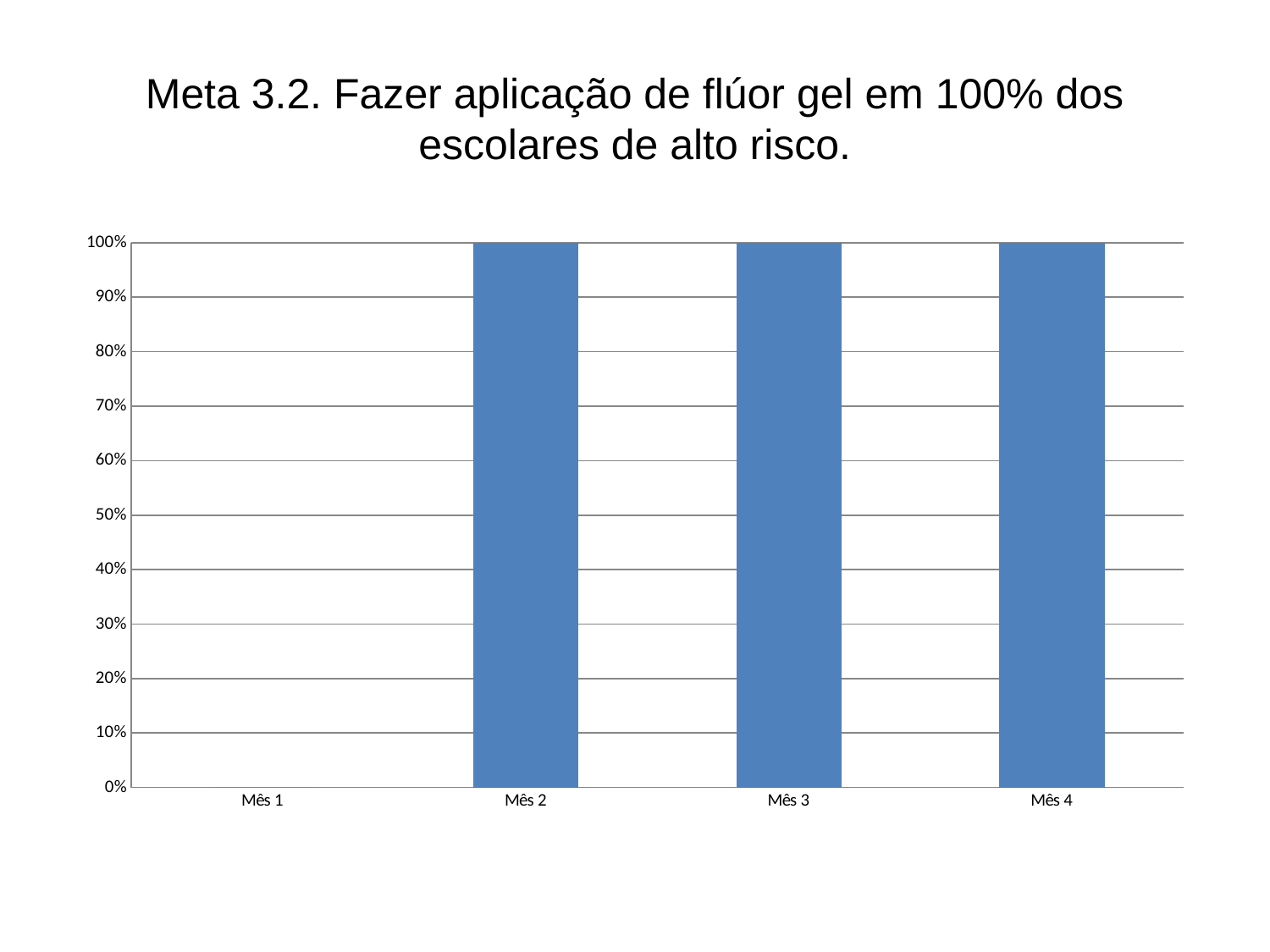
What is the highest tick value shown on the vertical axis? 100% What is the value for Mês 2? 100% What is the value for Mês 4? 100% Do the values rise or fall from Mês 1 to Mês 2? rise Which is larger, the value for Mês 1 or the value for Mês 3? Mês 3 Which category has the lowest value? Mês 1 Is the value for Mês 1 greater or less than 10%? less Is the value for Mês 3 greater or less than 50%? greater What is the value for Mês 1? 0% How many categories are shown on the x axis of the chart? 4 What is the difference between the value for Mês 2 and the value for Mês 1? 100% What kind of chart is shown on the slide? bar chart